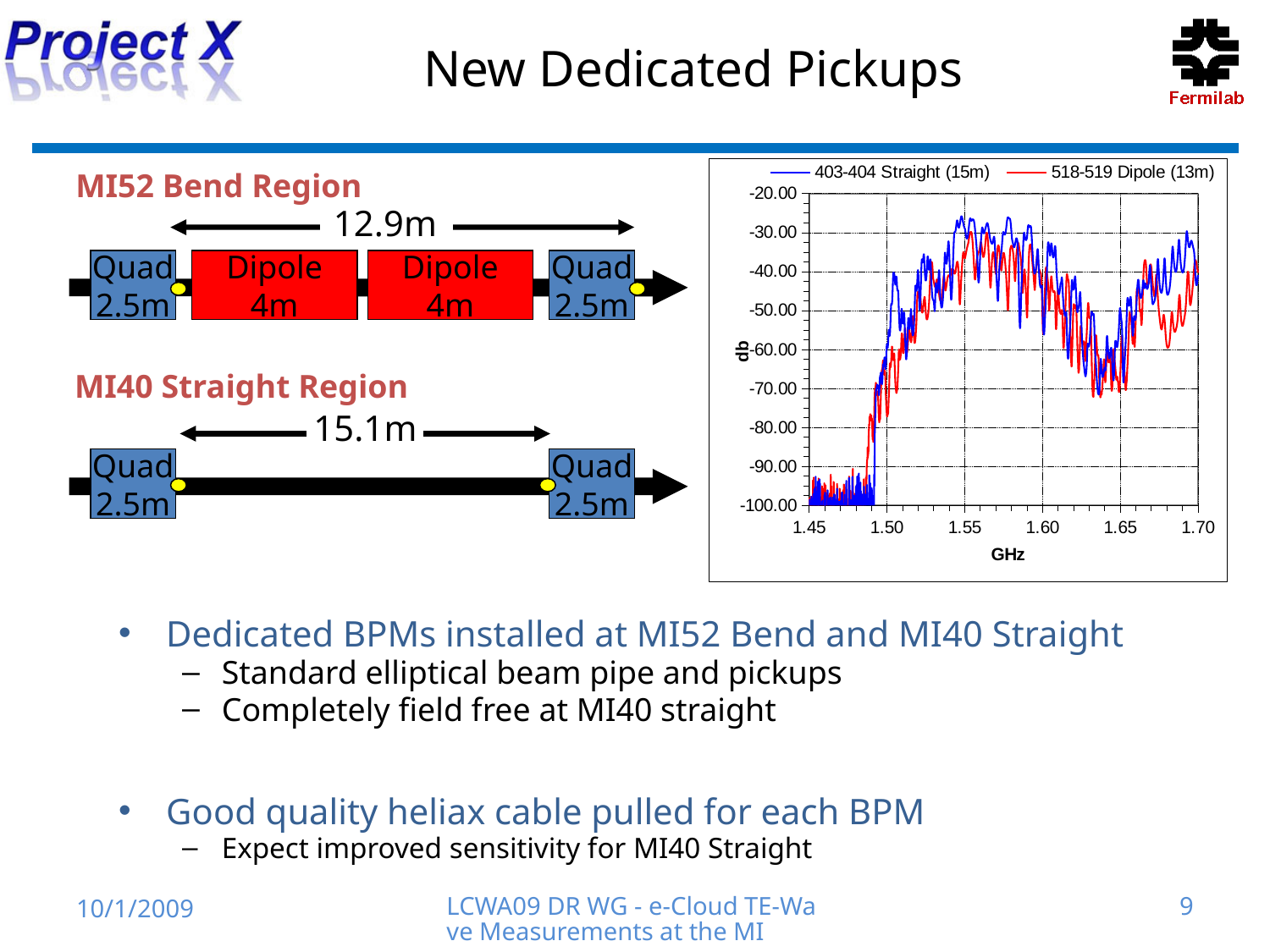
Is the value of the 403-404 Straight (15m) series at 1.45 GHz greater or less than -90.00 db? less What is the label of the y axis of the chart? db What is the lowest value shown on the y axis of the chart? -100.00 Which series in the chart is drawn in red? 518-519 Dipole (13m) Is the value of the 403-404 Straight (15m) series at 1.55 GHz greater or less than -40.00 db? greater How many series does the legend of the chart list? 2 What are the two series named in the chart legend? 403-404 Straight (15m) and 518-519 Dipole (13m) Do the values of the 518-519 Dipole (13m) series rise or fall between 1.45 GHz and 1.55 GHz? rise What is the highest value shown on the y axis of the chart? -20.00 What kind of chart is shown on the right side of the slide? line chart How many labelled tick values are shown on the x axis of the chart? 6 What is the label of the x axis of the chart? GHz